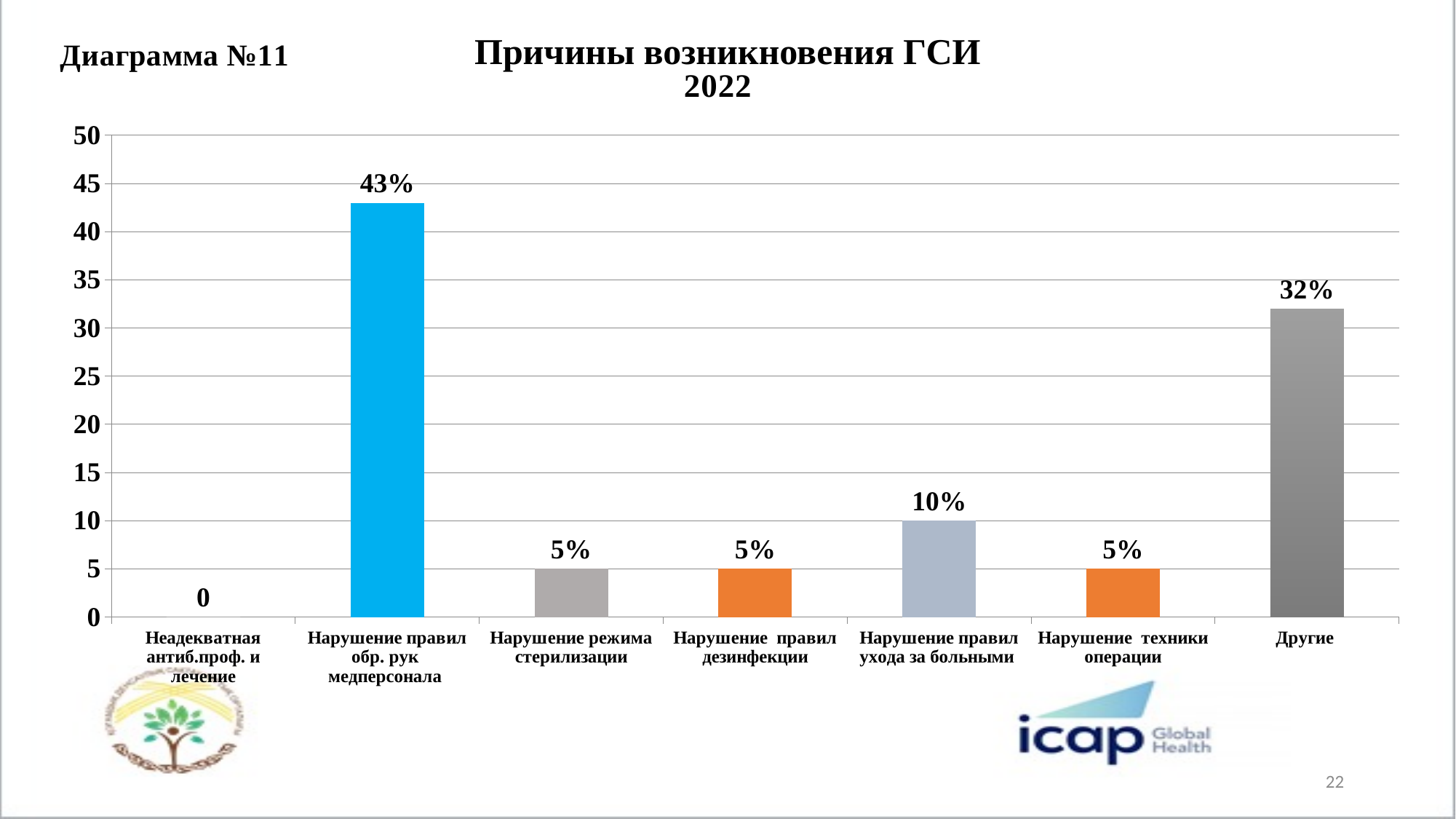
Which category has the highest value? Нарушение правил обр. рук медперсонала What is the value for Другие? 32% What is the difference between the values for Нарушение правил обр. рук медперсонала and Другие? 11% What is the value for Неадекватная антиб.проф. и лечение? 0 How many categories are shown on the x axis? 7 What is the value for Нарушение правил обр. рук медперсонала? 43% What kind of chart is shown on the slide? Bar chart What is the title of the chart? Причины возникновения ГСИ 2022 What is the value for Нарушение правил ухода за больными? 10% What is the value for Нарушение режима стерилизации? 5% Which is larger: the value for Нарушение правил ухода за больными or the value for Нарушение техники операции? Нарушение правил ухода за больными Which category has the lowest value? Неадекватная антиб.проф. и лечение